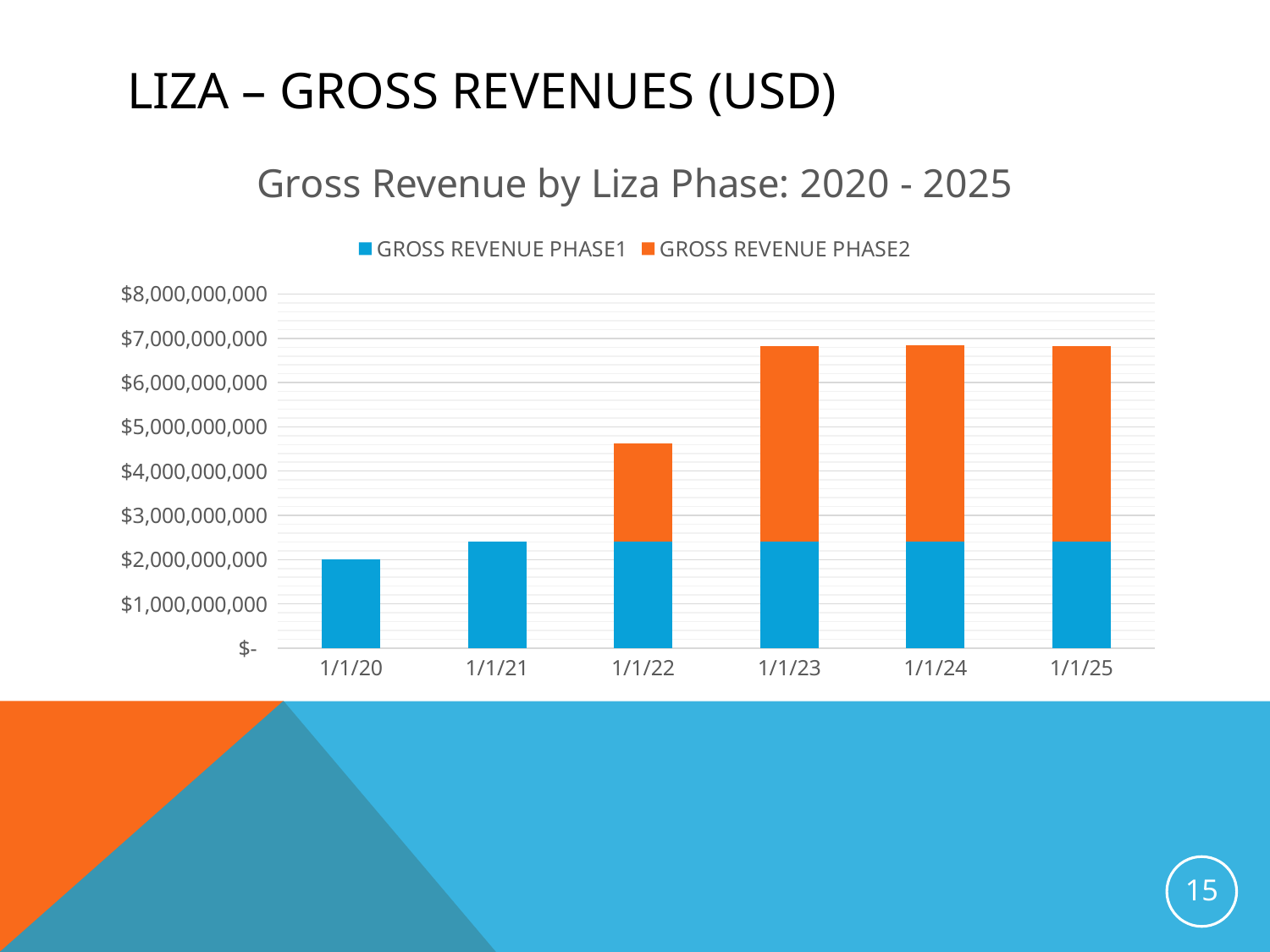
How many series does the legend list? 2 What kind of chart is shown on the slide? Stacked bar chart Which date has the lowest total bar? 1/1/20 Is the GROSS REVENUE PHASE1 value for 1/1/21 greater or less than $3,000,000,000? less How many dates are shown along the x axis? 6 What is the title of the chart? Gross Revenue by Liza Phase: 2020 - 2025 Which series is shown in orange? GROSS REVENUE PHASE2 Is the total bar for 1/1/22 greater or less than $5,000,000,000? less Is the total bar for 1/1/23 greater or less than $6,000,000,000? greater Which has the larger GROSS REVENUE PHASE2 value, 1/1/22 or 1/1/23? 1/1/23 Do the total bars rise or fall from 1/1/20 to 1/1/23? rise Which has the larger total bar, 1/1/21 or 1/1/22? 1/1/22